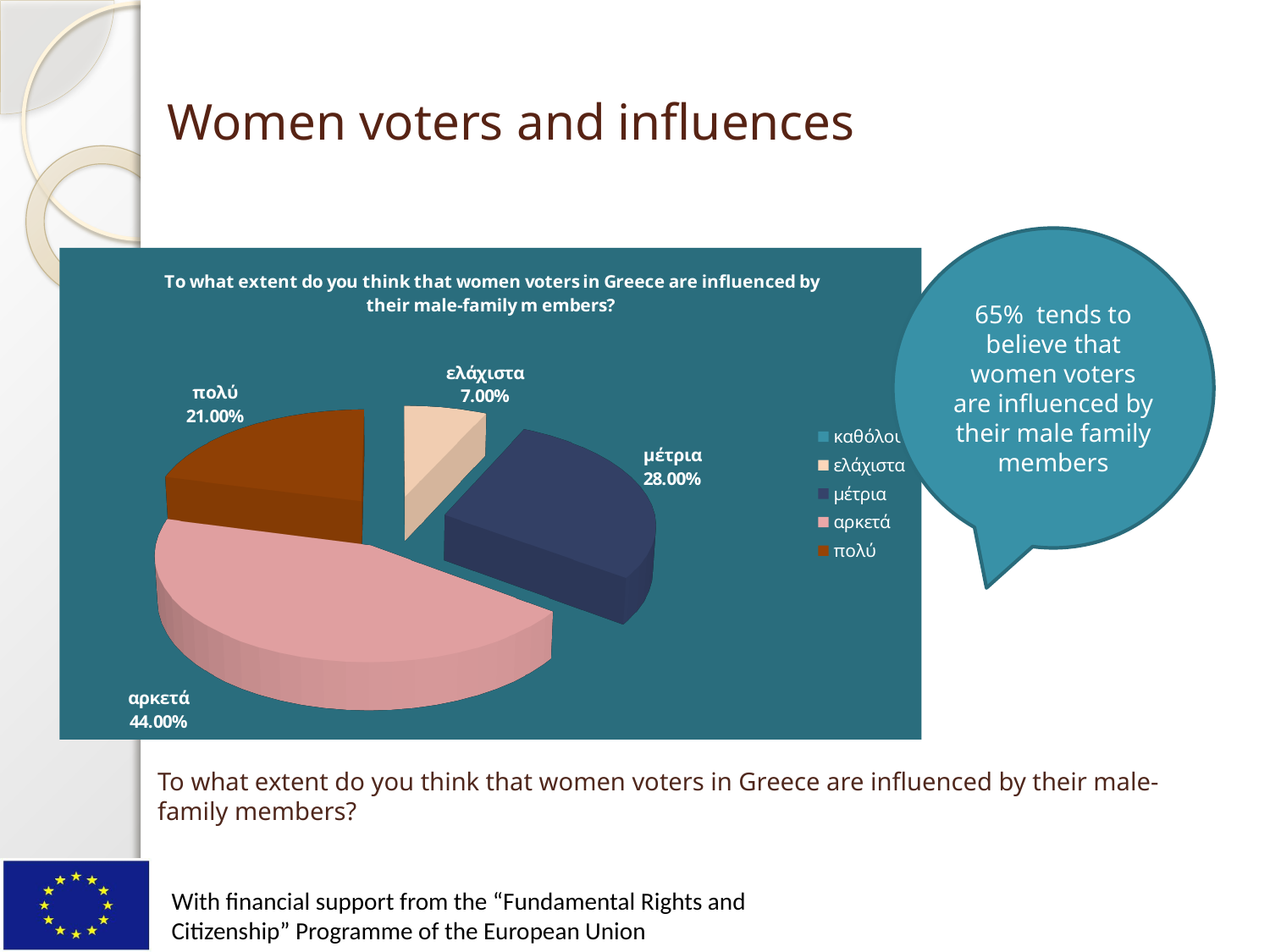
What colour is the "αρκετά" slice in the pie chart? pink What percentage is shown for the "μέτρια" slice? 28.00% What percentage is shown for the "ελάχιστα" slice? 7.00% What percentage is shown for the "πολύ" slice? 21.00% Which slice is larger, "πολύ" or "μέτρια"? μέτρια Which of the labelled slices is the smallest? ελάχιστα What percentage is shown for the "αρκετά" slice? 44.00% How many entries does the chart legend list? 5 What is the combined percentage of the "αρκετά" and "πολύ" slices? 65.00% What is the difference in percentage points between the "αρκετά" and "μέτρια" slices? 16.00% What kind of chart is shown on the slide? pie chart Which category has the largest slice of the pie? αρκετά